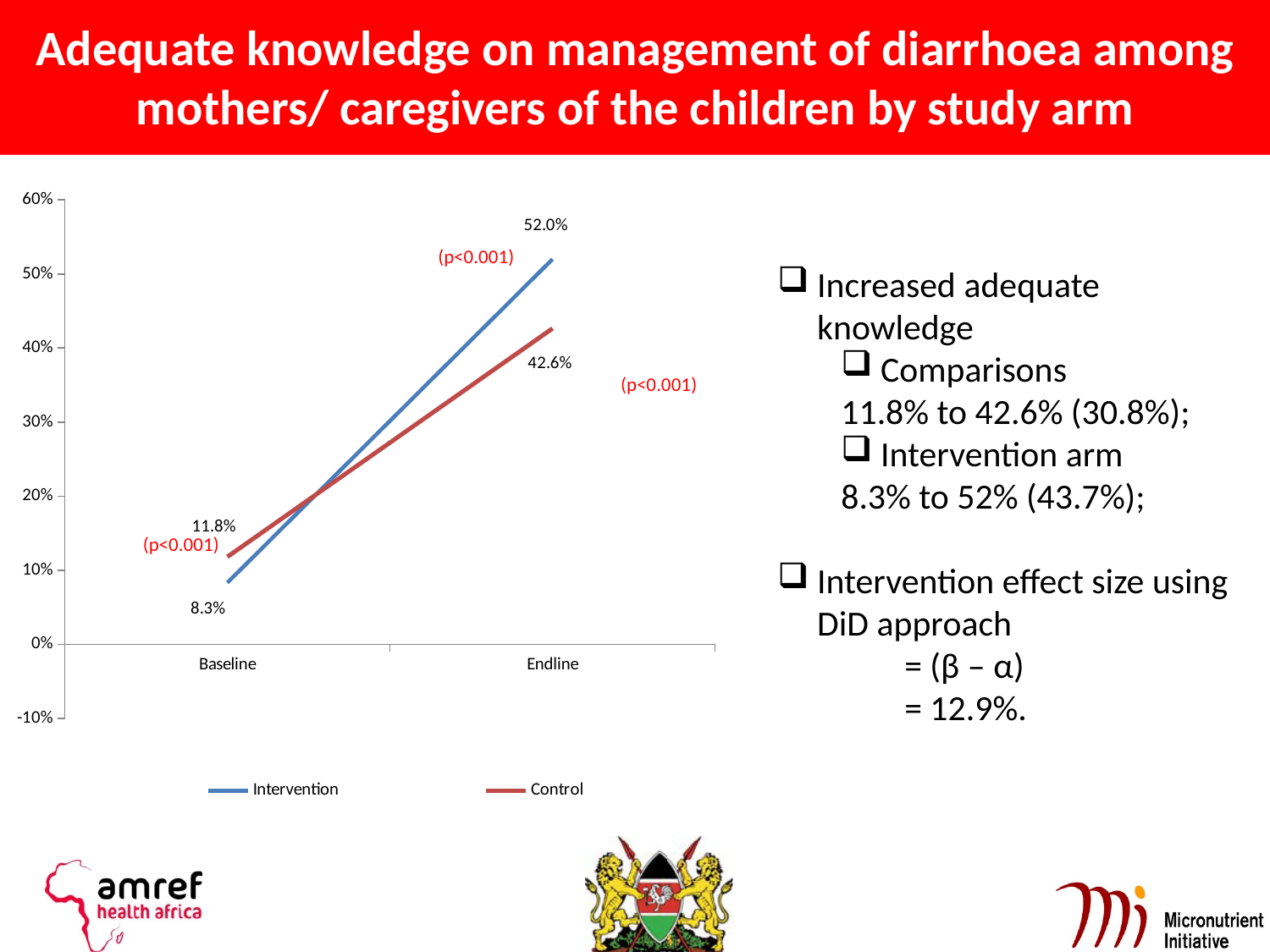
How many series does the legend list? 2 What kind of chart is shown on the slide? Line chart Which series has the higher value at Baseline? Control Which series has the higher value at Endline? Intervention What is the difference between the Intervention and Control values at Endline? 9.4% What is the value for the Intervention series at Endline? 52.0% How many categories are shown on the x axis? 2 Does the Control series rise or fall from Baseline to Endline? Rise What is the value for the Intervention series at Baseline? 8.3% What is the value for the Control series at Baseline? 11.8% What is the difference between the Intervention values at Endline and Baseline? 43.7% What is the value for the Control series at Endline? 42.6%